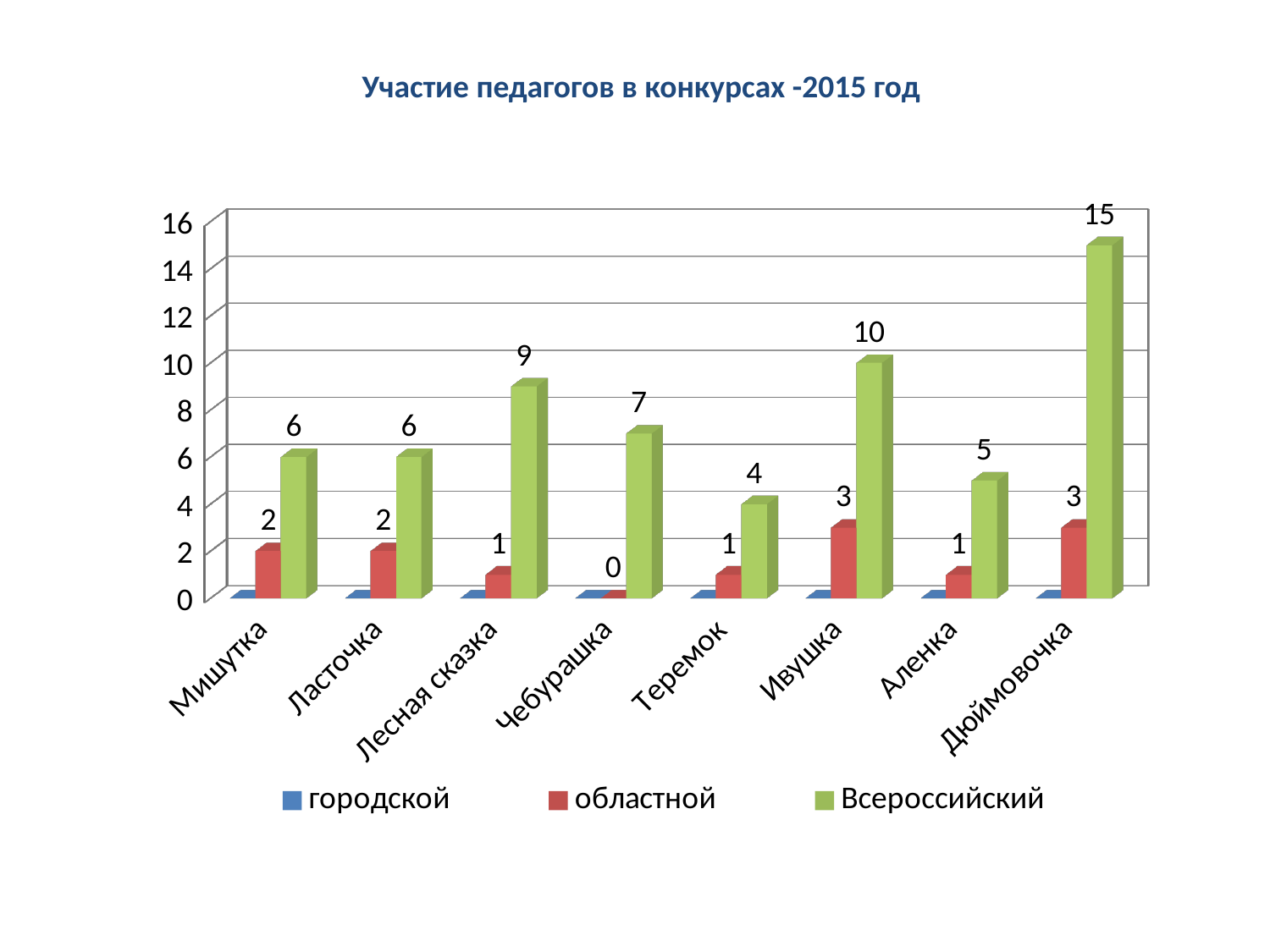
Which category has the highest Всероссийский value? Дюймовочка Which is larger, the Всероссийский value for Лесная сказка or for Чебурашка? Лесная сказка Which category has the lowest Всероссийский value? Теремок What is the difference between the Всероссийский values for Дюймовочка and Ивушка? 5 What is the Всероссийский value for Дюймовочка? 15 How many categories are shown on the x axis? 8 What is the областной value for Ивушка? 3 What kind of chart is shown on the slide? Bar chart What is the областной value for Чебурашка? 0 What is the title of the chart? Участие педагогов в конкурсах -2015 год What is the Всероссийский value for Теремок? 4 How many series does the legend list? 3